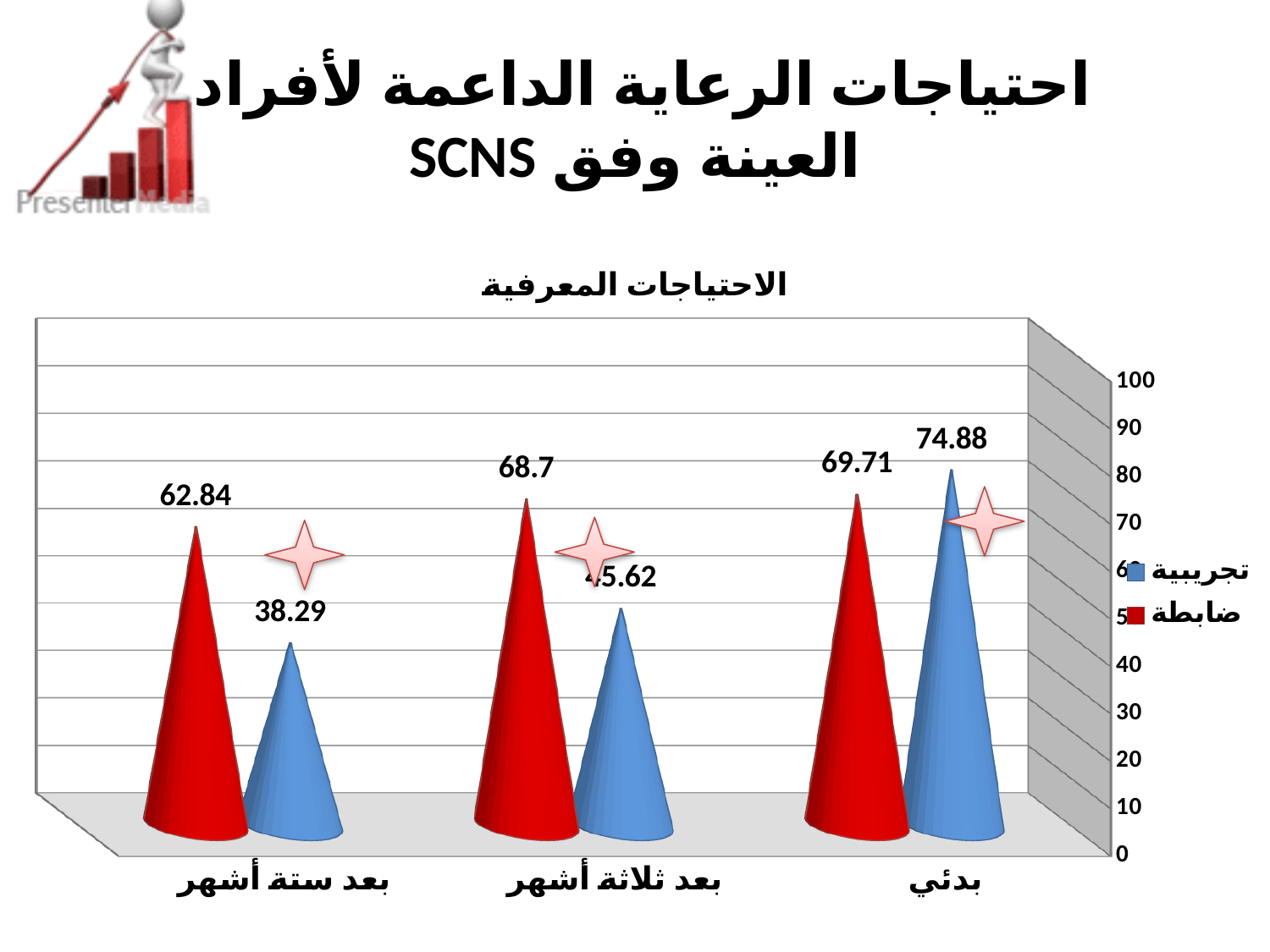
What is the value of the ضابطة series for the بدئي category? 69.71 How many series does the legend list? 2 In which category does the تجريبية series reach its highest value? بدئي What is the value of the تجريبية series for بعد ستة أشهر? 38.29 What is the value of the ضابطة series for بعد ستة أشهر? 62.84 In which category does the تجريبية series have its lowest value? بعد ستة أشهر For بعد ستة أشهر, what is the difference between the ضابطة value and the تجريبية value? 24.55 What is the value of the ضابطة series for بعد ثلاثة أشهر? 68.7 What kind of chart is shown on the slide? bar chart What is the value of the تجريبية series for the بدئي category? 74.88 Is the تجريبية value for بعد ثلاثة أشهر greater or less than 50? less For the بدئي category, which series has the larger value, تجريبية or ضابطة? تجريبية